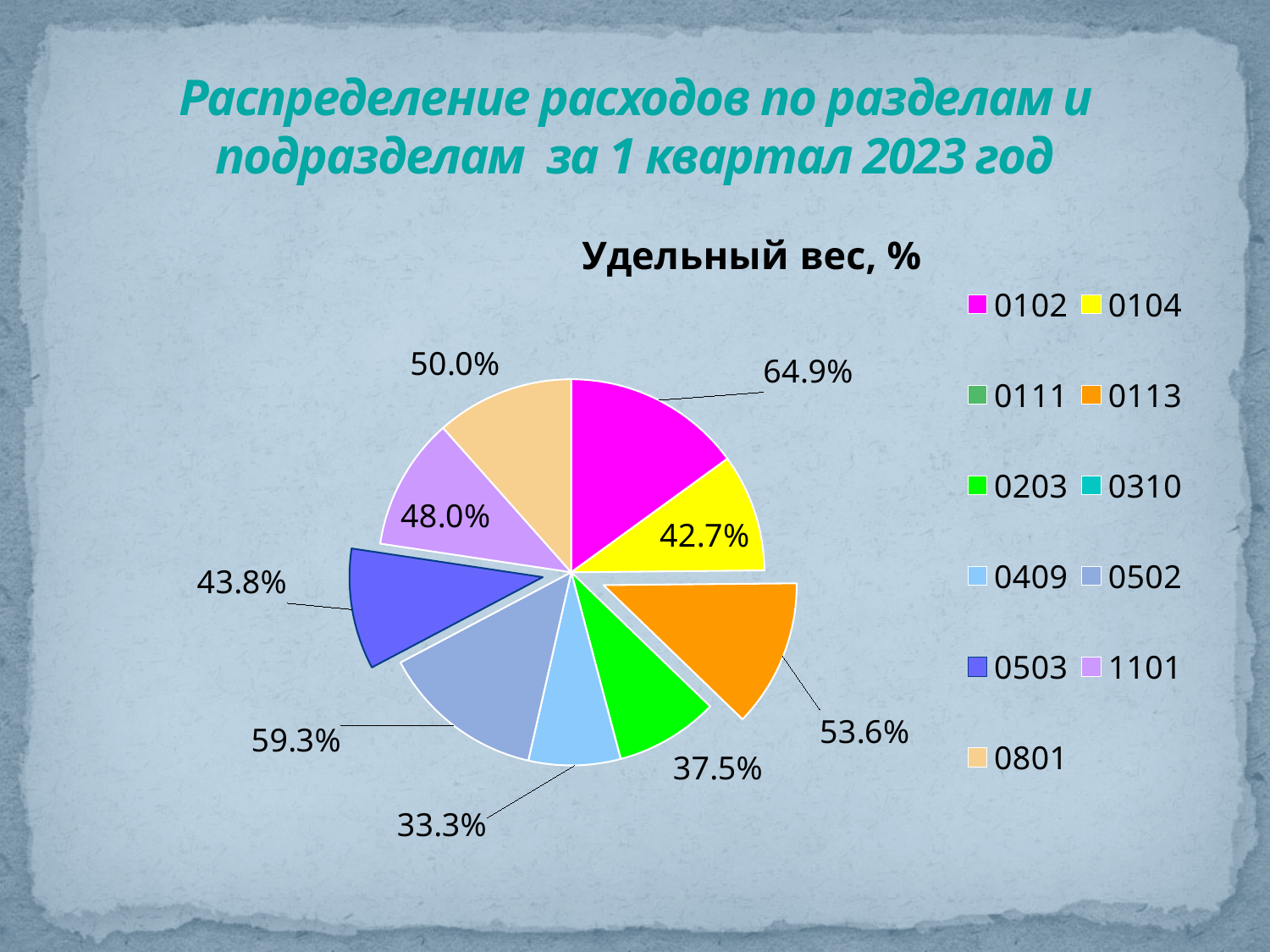
What is the data label shown for category 0801 in the pie chart? 50.0% Which category has the lowest data label among the visible slices of the pie chart? 0409 What is the data label shown for category 0113 in the pie chart? 53.6% Which category has the highest data label in the pie chart? 0102 What is the title of the chart on the slide? Удельный вес, % What type of chart is shown on the slide? Pie chart What is the data label shown for category 0409 in the pie chart? 33.3% What is the data label shown for category 0102 in the pie chart? 64.9% What is the difference between the data labels for 0502 and 0113? 5.7% How many entries does the legend of the pie chart list? 11 What is the difference between the data labels for 0102 and 0104? 22.2% Which has the larger data label, 0503 or 0104? 0503